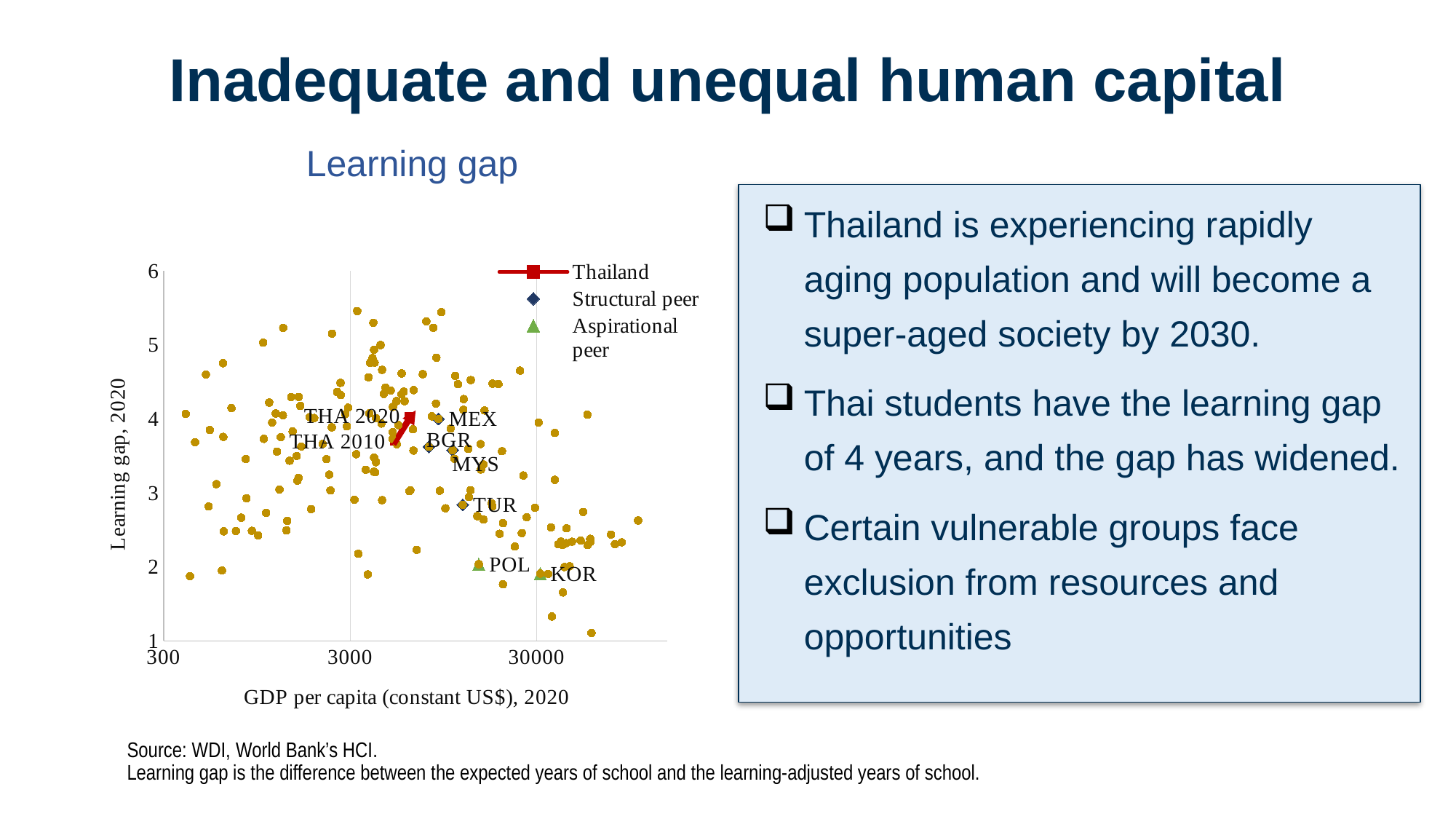
What is the x-axis label of the Learning gap chart? GDP per capita (constant US$), 2020 In the Learning gap chart, is the GDP per capita for TUR greater or less than 30000? less In the Learning gap chart, which has the larger learning gap, THA 2020 or THA 2010? THA 2020 In the Learning gap chart, which has the larger learning gap, MEX or KOR? MEX In the Learning gap chart, which of the labelled structural peers has the lowest learning gap? TUR How many series does the legend of the Learning gap chart list? 3 In the Learning gap chart, is the learning gap for MYS greater or less than 4? less Which series in the Learning gap chart is marked with a red square? Thailand In the Learning gap chart, is the learning gap for TUR greater or less than 3? less How many structural peers are labelled by name in the Learning gap chart? 4 How many aspirational peers are labelled by name in the Learning gap chart? 2 What kind of chart is shown under the heading "Learning gap"? Scatter chart